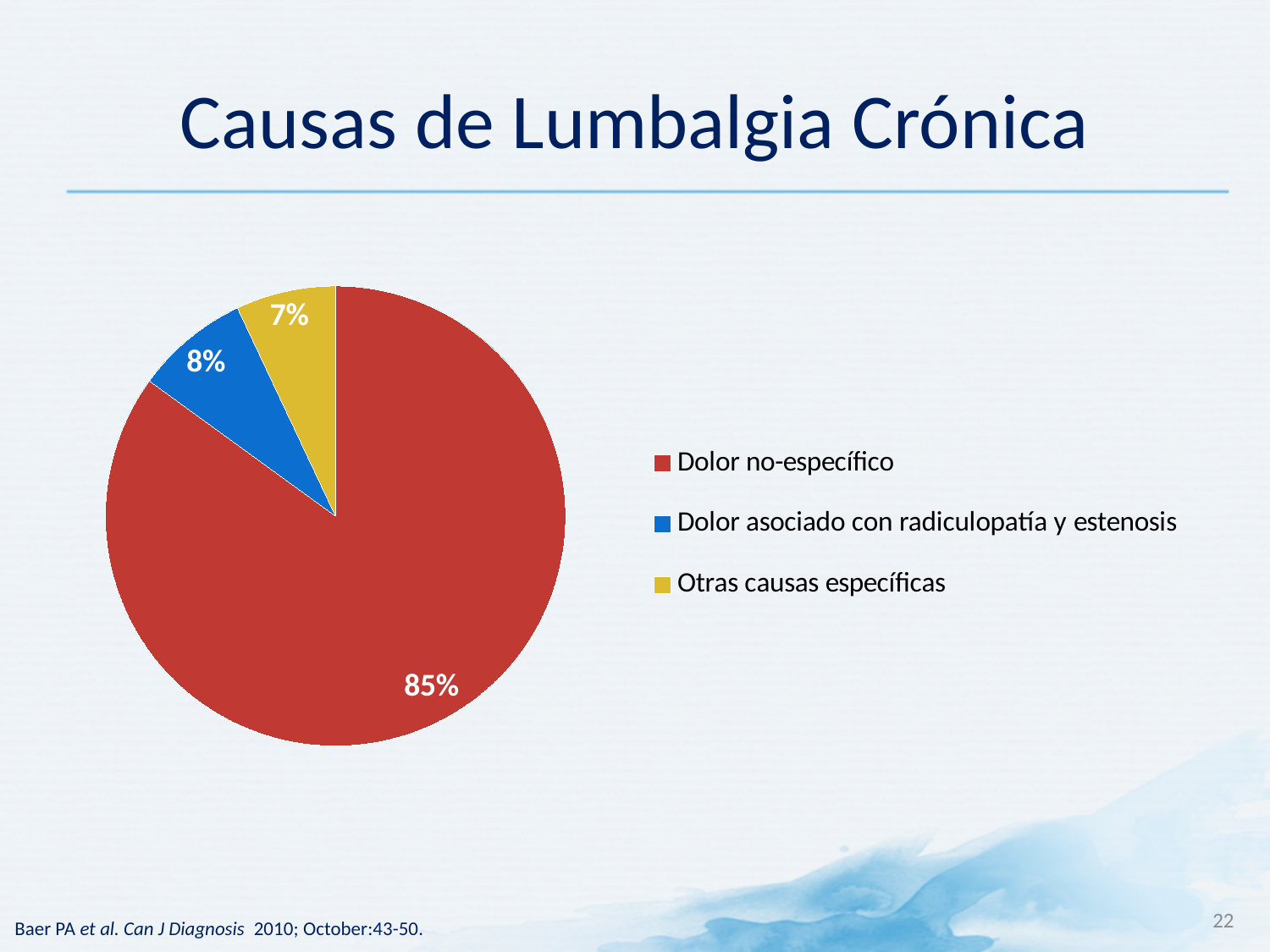
What share of the pie is labelled for Dolor asociado con radiculopatía y estenosis? 8% What share of the pie is labelled for Otras causas específicas? 7% What is the difference between the share for Dolor asociado con radiculopatía y estenosis and the share for Otras causas específicas? 1% What kind of chart is shown on the slide? pie chart How many categories does the pie chart show? 3 What is the title of the slide containing the pie chart? Causas de Lumbalgia Crónica Which category has the largest slice of the pie? Dolor no-específico Which category has the smallest slice of the pie? Otras causas específicas What colour is the slice for Dolor asociado con radiculopatía y estenosis? blue Which is larger, the share for Dolor no-específico or the share for Otras causas específicas? Dolor no-específico What share of the pie is labelled for Dolor no-específico? 85% What is the difference between the share for Dolor no-específico and the share for Dolor asociado con radiculopatía y estenosis? 77%